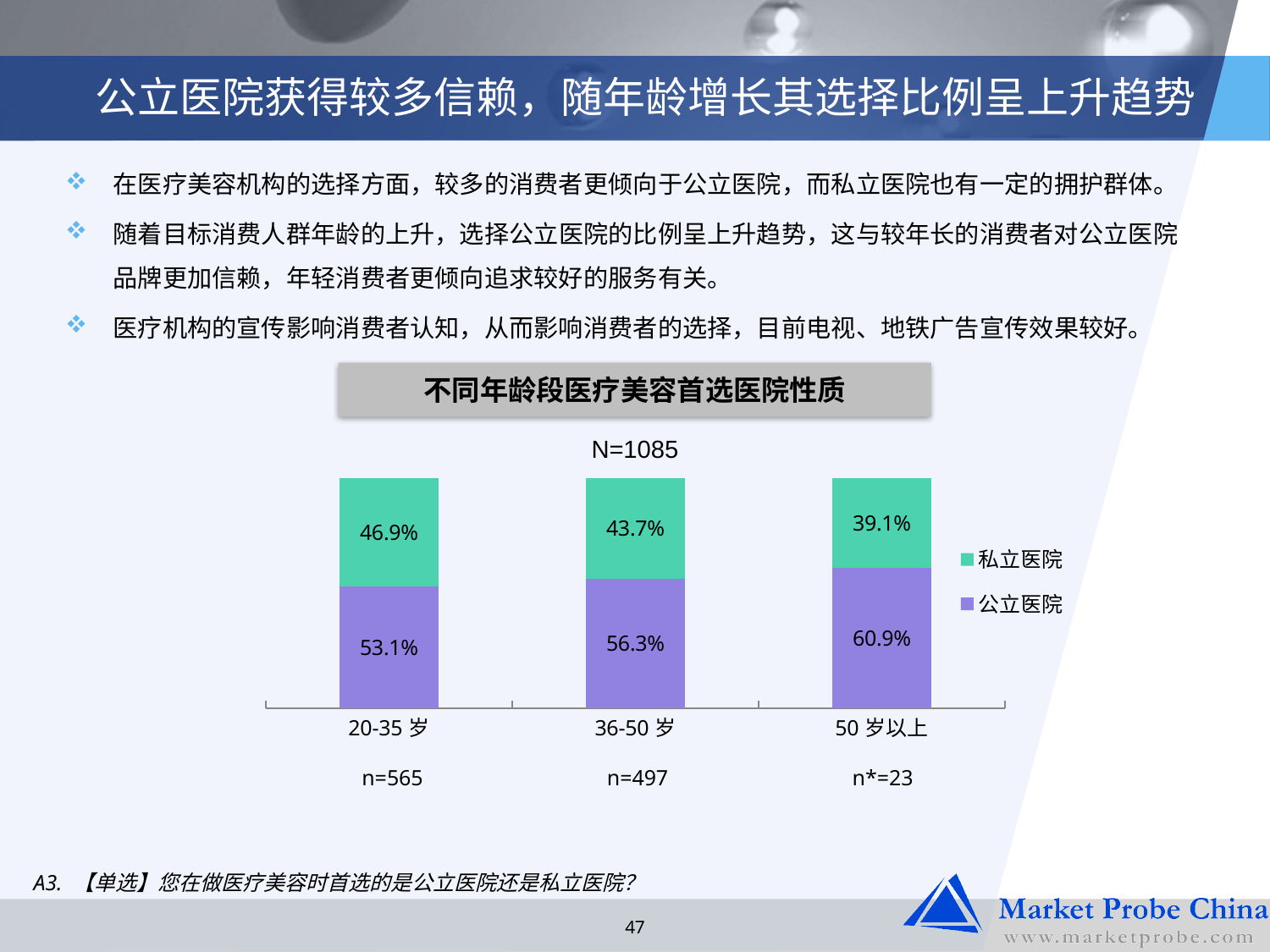
How many series does the legend list? 2 What kind of chart is shown? Stacked bar chart What percentage of the 20-35 岁 group chose 公立医院? 53.1% What is the title of the chart? 不同年龄段医疗美容首选医院性质 What percentage of the 36-50 岁 group chose 私立医院? 43.7% Which is larger for the 36-50 岁 group: the 公立医院 share or the 私立医院 share? 公立医院 What percentage of the 50 岁以上 group chose 公立医院? 60.9% Which age group has the lowest share choosing 私立医院? 50 岁以上 Does the 公立医院 share rise or fall as age increases along the x axis? Rises Which age group has the highest share choosing 公立医院? 50 岁以上 What is the difference between the 公立医院 share for 50 岁以上 and for 20-35 岁? 7.8% How many age groups are shown on the x axis? 3